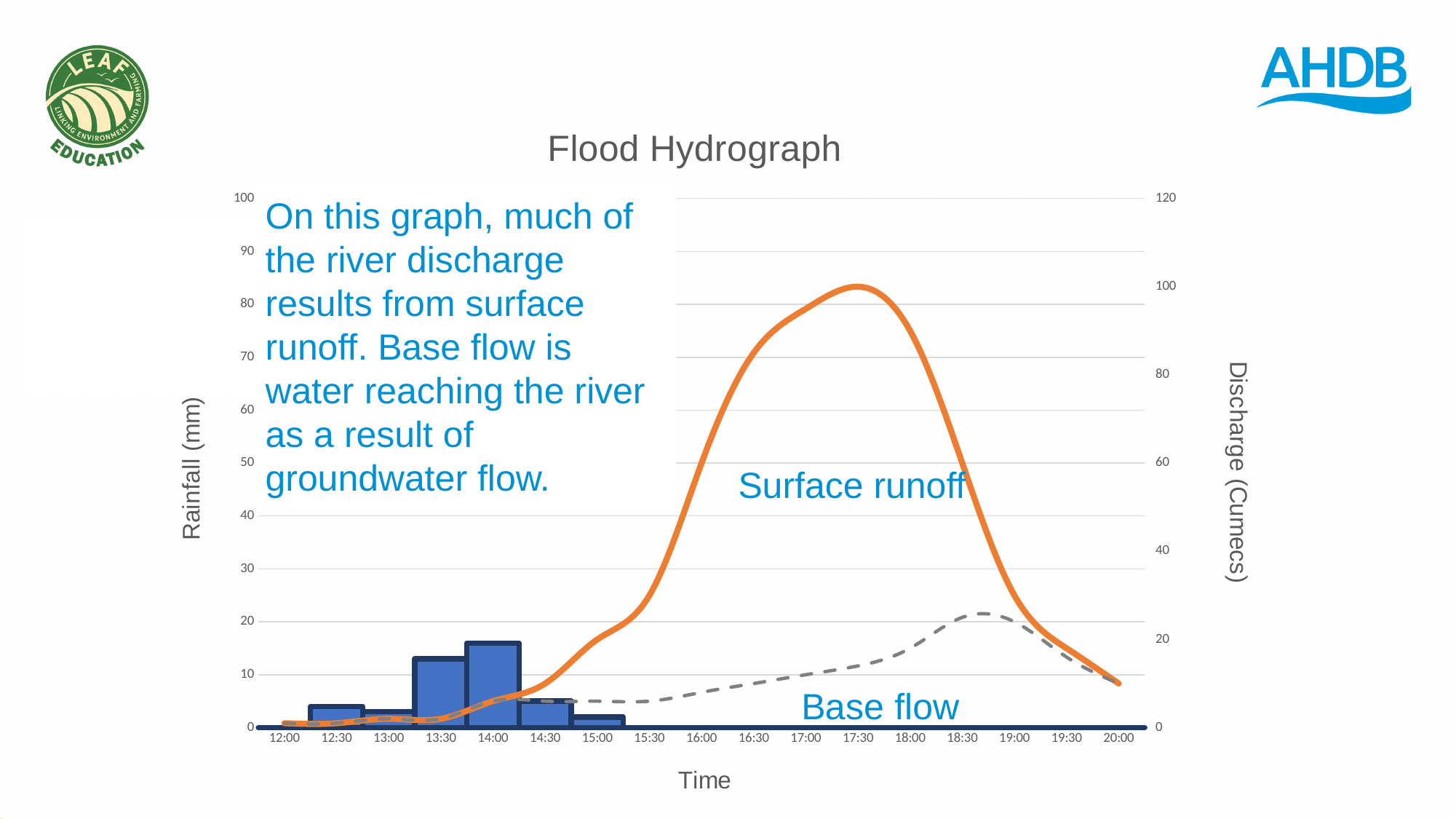
Is the rainfall at 14:00 greater or less than 10 mm? greater How many time labels are shown on the x axis? 17 At which time is the rainfall bar highest? 14:00 What is the label of the left vertical axis? Rainfall (mm) Which is larger, the rainfall at 13:30 or at 14:30? 13:30 Is the peak of the surface runoff line greater or less than 80 cumecs? greater What kind of chart is shown on the slide? A combined bar and line chart Does the surface runoff line rise or fall between 17:30 and 20:00? fall Is the rainfall at 14:30 greater or less than 10 mm? less Around which time does the surface runoff (orange) line reach its peak? 17:30 What is the title of the chart? Flood Hydrograph